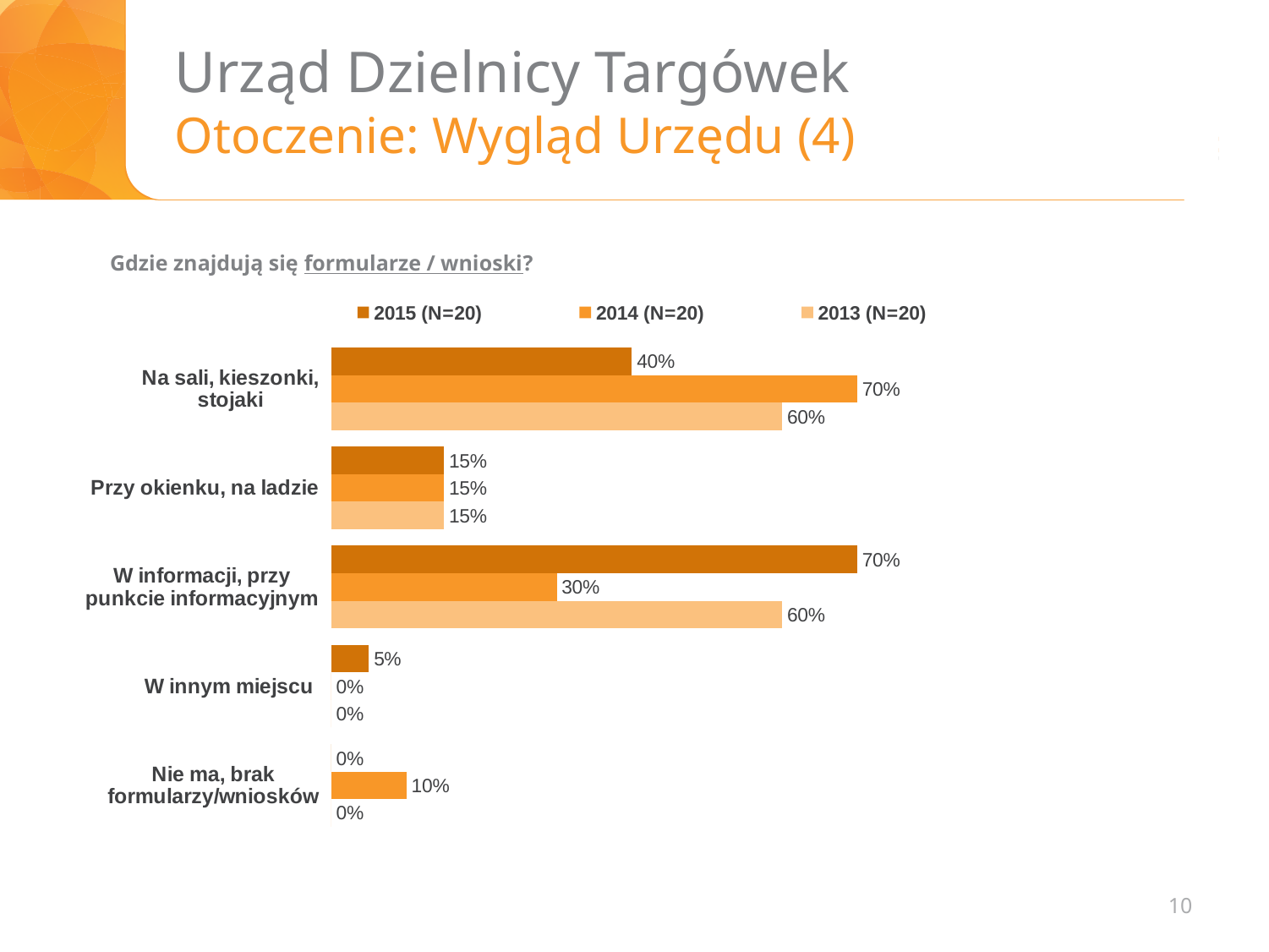
What question does the chart answer, as stated above it? Gdzie znajdują się formularze / wnioski? What is the value for "W innym miejscu" in the 2015 (N=20) series? 5% Which category has the highest value in the 2015 (N=20) series? W informacji, przy punkcie informacyjnym What is the value for "W informacji, przy punkcie informacyjnym" in the 2014 (N=20) series? 30% How many series does the legend list? 3 How many categories are shown on the chart? 5 Which category has the highest value in the 2014 (N=20) series? Na sali, kieszonki, stojaki What is the value for "Nie ma, brak formularzy/wniosków" in the 2014 (N=20) series? 10% What is the value for "Na sali, kieszonki, stojaki" in the 2015 (N=20) series? 40% What kind of chart is shown on the slide? Bar chart What is the difference between the 2014 (N=20) and 2015 (N=20) values for "Na sali, kieszonki, stojaki"? 30% Which is larger for "W informacji, przy punkcie informacyjnym": the 2015 (N=20) value or the 2013 (N=20) value? 2015 (N=20)